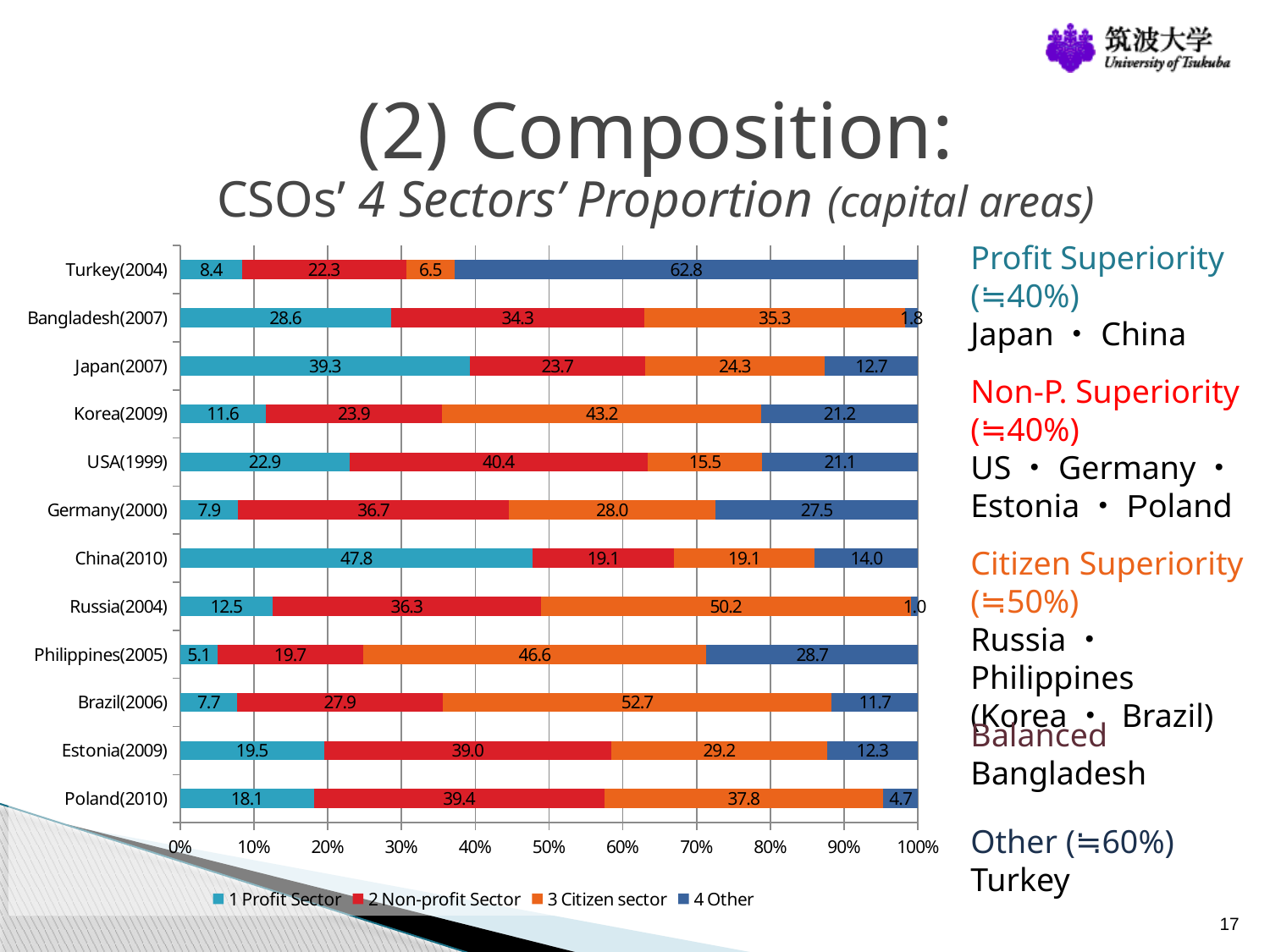
Which is larger for Korea(2009): the 3 Citizen sector value or the 2 Non-profit Sector value? 3 Citizen sector What is the total of the four segments for Turkey(2004)? 100.0 Which country has the lowest 1 Profit Sector value? Philippines(2005) Which country has the highest 1 Profit Sector value? China(2010) What is the value of the 1 Profit Sector segment for Japan(2007)? 39.3 How many countries are shown on the chart? 12 What kind of chart is shown on the slide? Stacked bar chart What is the value of the 4 Other segment for Turkey(2004)? 62.8 What is the difference between the 1 Profit Sector and 2 Non-profit Sector values for Japan(2007)? 15.6 What is the value of the 3 Citizen sector segment for Brazil(2006)? 52.7 How many series does the legend list? 4 What is the value of the 2 Non-profit Sector segment for USA(1999)? 40.4